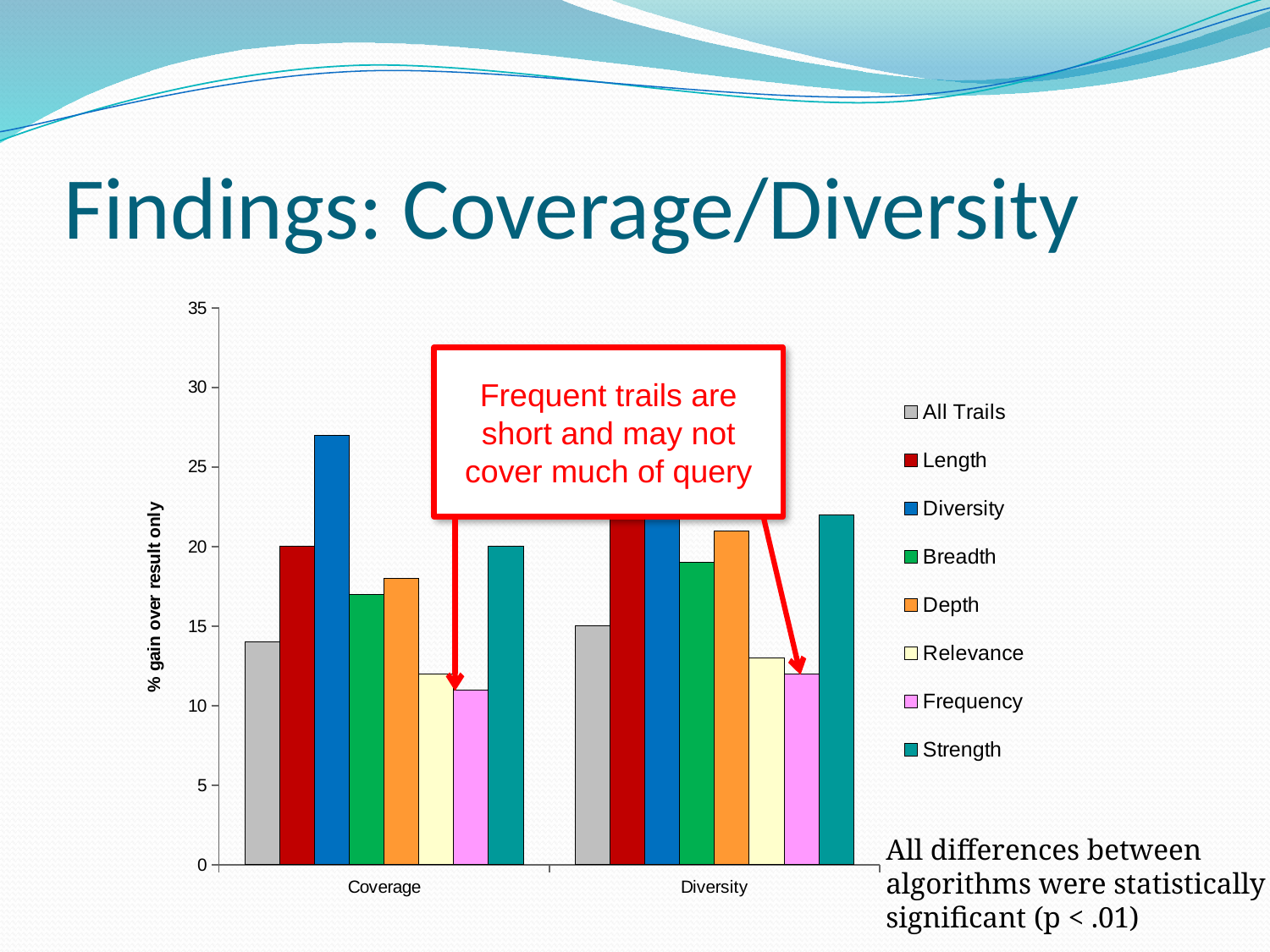
How many categories are shown on the x axis? 2 Which series has the lowest value in the Coverage category? Frequency What kind of chart is shown on the slide? bar chart Is the value for All Trails in the Coverage category greater or less than 15? less Is the value for Frequency in the Diversity category greater or less than 15? less In the Diversity category, which is larger: Depth or Breadth? Depth Is the value for Strength in the Diversity category greater or less than 20? greater What is the label on the vertical axis? % gain over result only Which series has the highest value in the Coverage category? Diversity In the Coverage category, which is larger: Strength or All Trails? Strength How many series does the legend list? 8